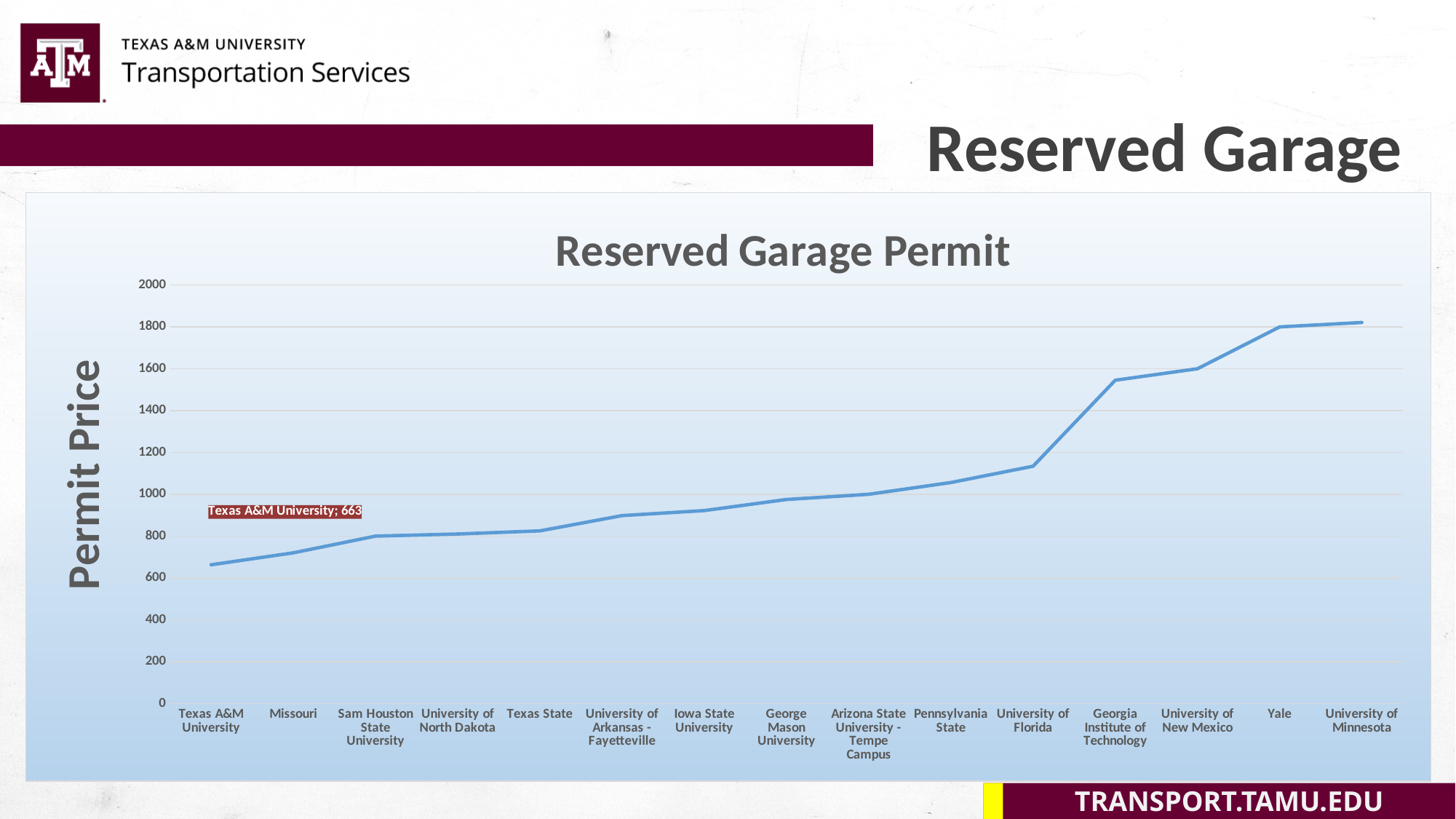
Which has the higher permit price, Georgia Institute of Technology or University of Florida? Georgia Institute of Technology What is the permit price shown for Texas A&M University? 663 How many universities are plotted along the x axis? 15 What is the label on the vertical axis of the chart? Permit Price Is the permit price for Georgia Institute of Technology greater or less than 1400? greater What is the title of the chart? Reserved Garage Permit Which university has the lowest reserved garage permit price? Texas A&M University What kind of chart is shown on the slide? Line chart Is the permit price for University of Florida greater or less than 1200? less Do the permit prices rise or fall moving from left to right along the x axis? Rise Is the permit price for Iowa State University greater or less than 1000? less